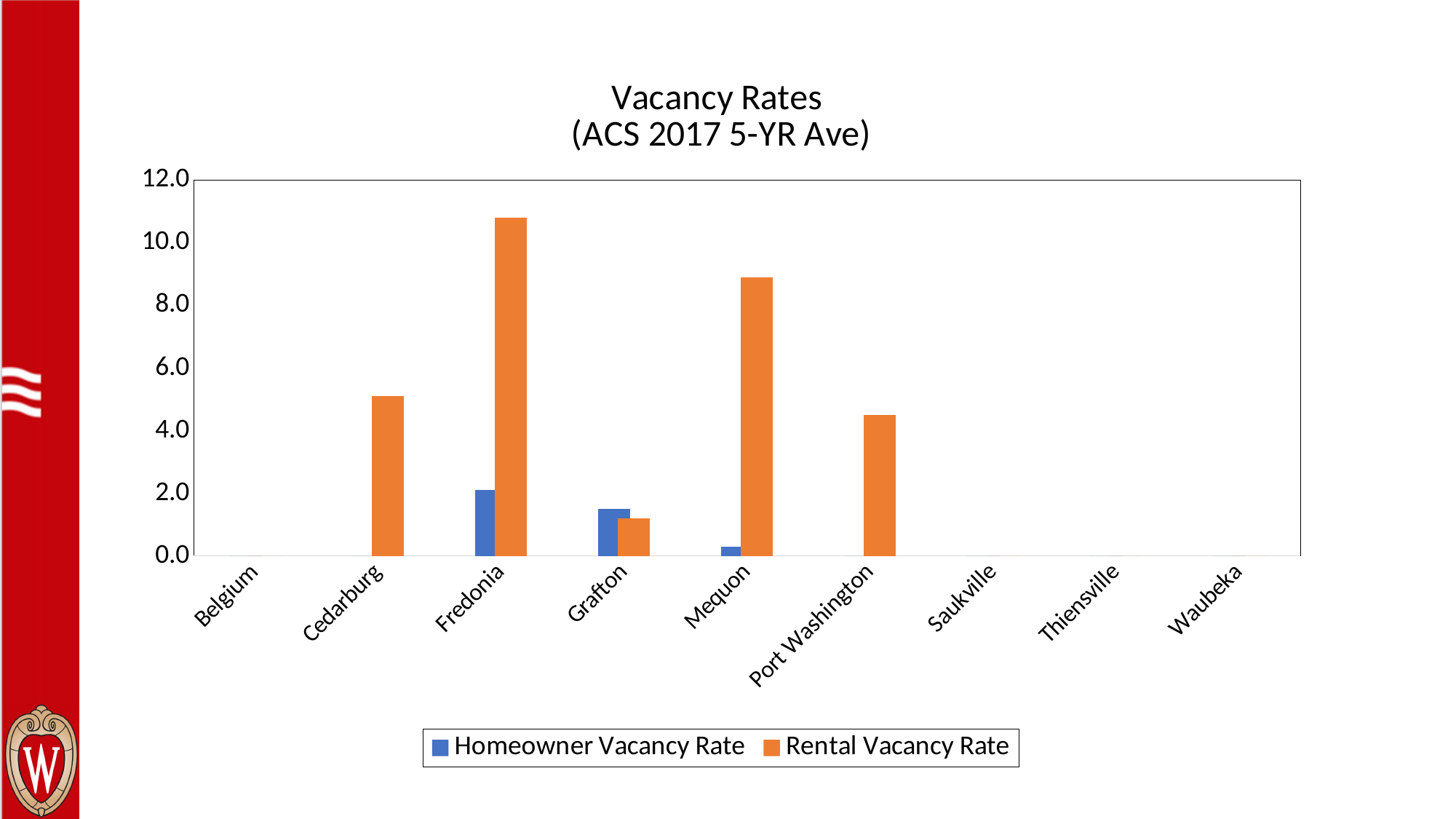
Which is larger, the Rental Vacancy Rate for Cedarburg or the Rental Vacancy Rate for Mequon? Mequon Is the Homeowner Vacancy Rate for Fredonia greater or less than 4.0? less Is the Rental Vacancy Rate for Fredonia greater or less than 10.0? greater Which is larger for Grafton, the Homeowner Vacancy Rate or the Rental Vacancy Rate? Homeowner Vacancy Rate Is the Rental Vacancy Rate for Port Washington greater or less than 6.0? less What kind of chart is shown on the slide? bar chart How many series does the legend list? 2 Which community has the highest Rental Vacancy Rate? Fredonia What is the title of the chart? Vacancy Rates (ACS 2017 5-YR Ave) Which community has the highest Homeowner Vacancy Rate? Fredonia How many communities are listed along the x axis of the chart? 9